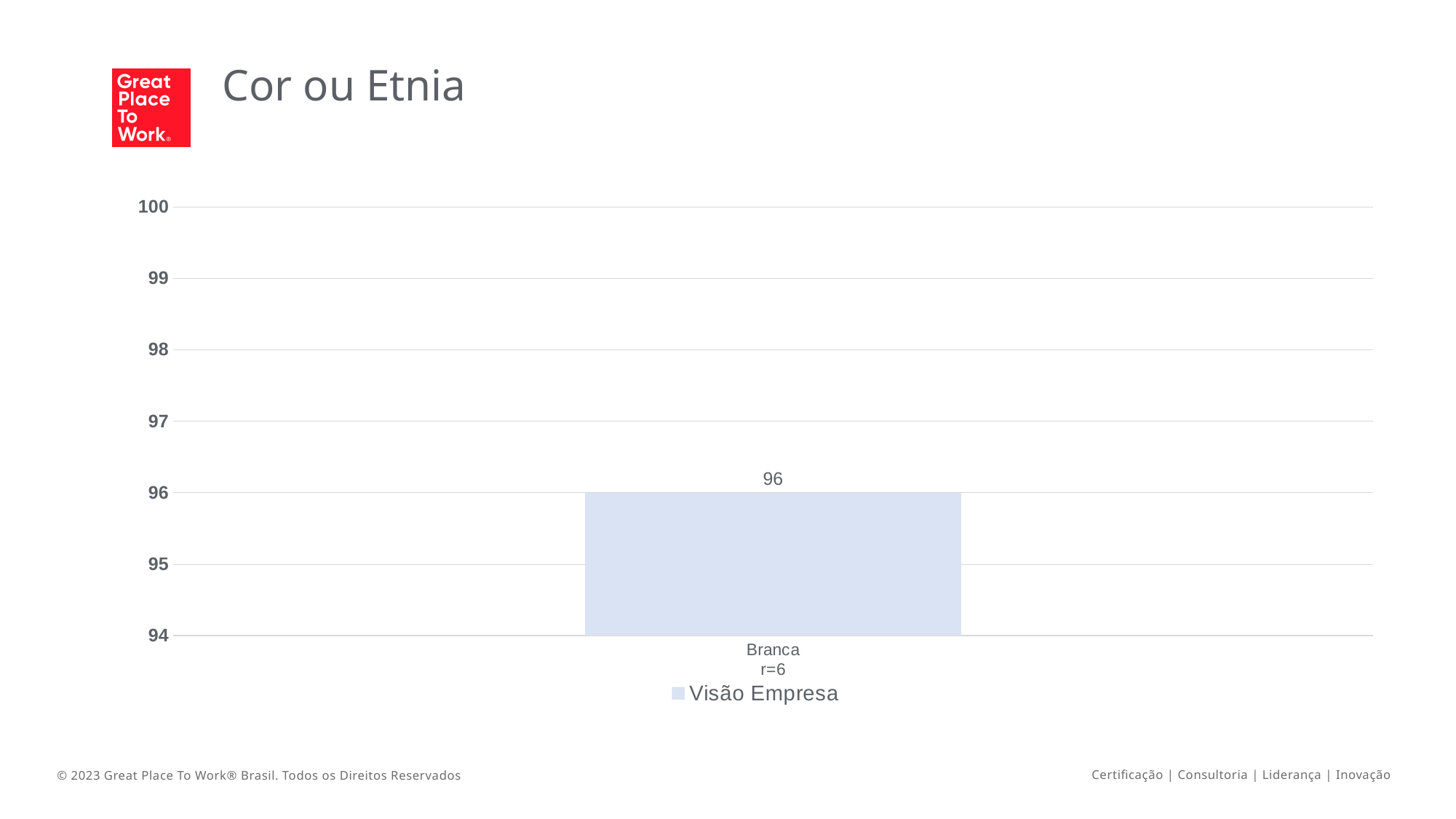
What kind of chart is shown on the slide? bar chart How many series does the legend list? 1 What is the lowest value shown on the y axis? 94 How many categories are plotted on the chart? 1 Is the value for Branca greater or less than 98? less What is the highest value shown on the y axis? 100 What is the value for Branca in the Visão Empresa series? 96 What series name is shown in the chart legend? Visão Empresa Is the value for Branca greater or less than 95? greater What is the title of the slide containing the chart? Cor ou Etnia What is the label of the only category on the x axis? Branca